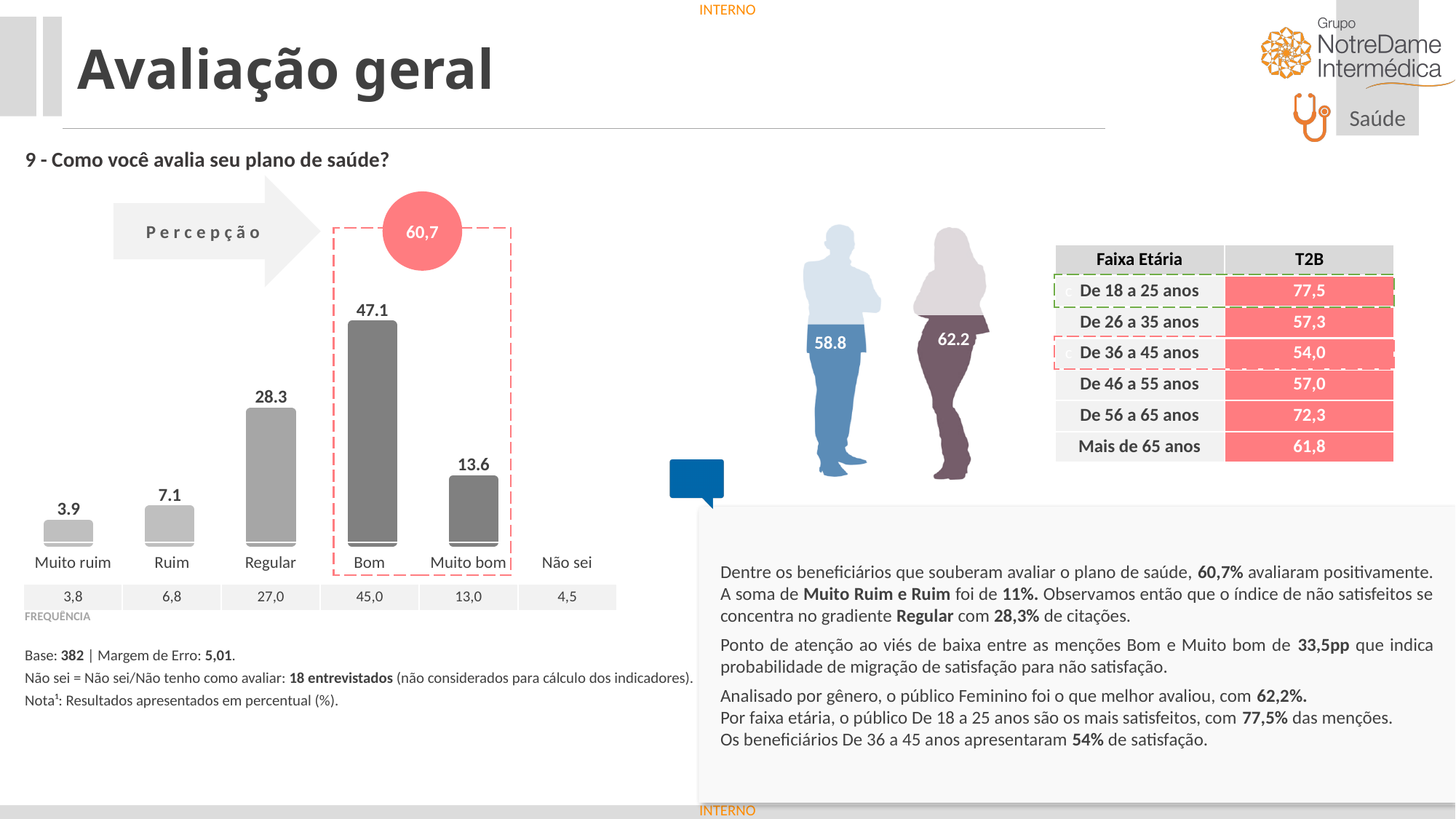
Which category has the highest bar in the bar chart? Bom In the 'Faixa Etária / T2B' table, which age group has the lowest T2B value? De 36 a 45 anos What type of chart is used to show the answers to 'Como você avalia seu plano de saúde?' bar chart In the bar chart, what is the difference between the values for 'Bom' and 'Muito bom'? 33.5 In the bar chart, what is the value for 'Bom'? 47.1 Which category has the lowest bar in the bar chart? Muito ruim In the bar chart, what is the value for 'Muito ruim'? 3.9 In the 'Faixa Etária / T2B' table, what is the T2B value for 'De 56 a 65 anos'? 72,3 In the bar chart, which is larger: the value for 'Regular' or the value for 'Muito bom'? Regular What value is shown in the red circle above the dashed box around 'Bom' and 'Muito bom'? 60,7 How many bars are plotted in the bar chart? 5 In the bar chart, what is the value for 'Regular'? 28.3